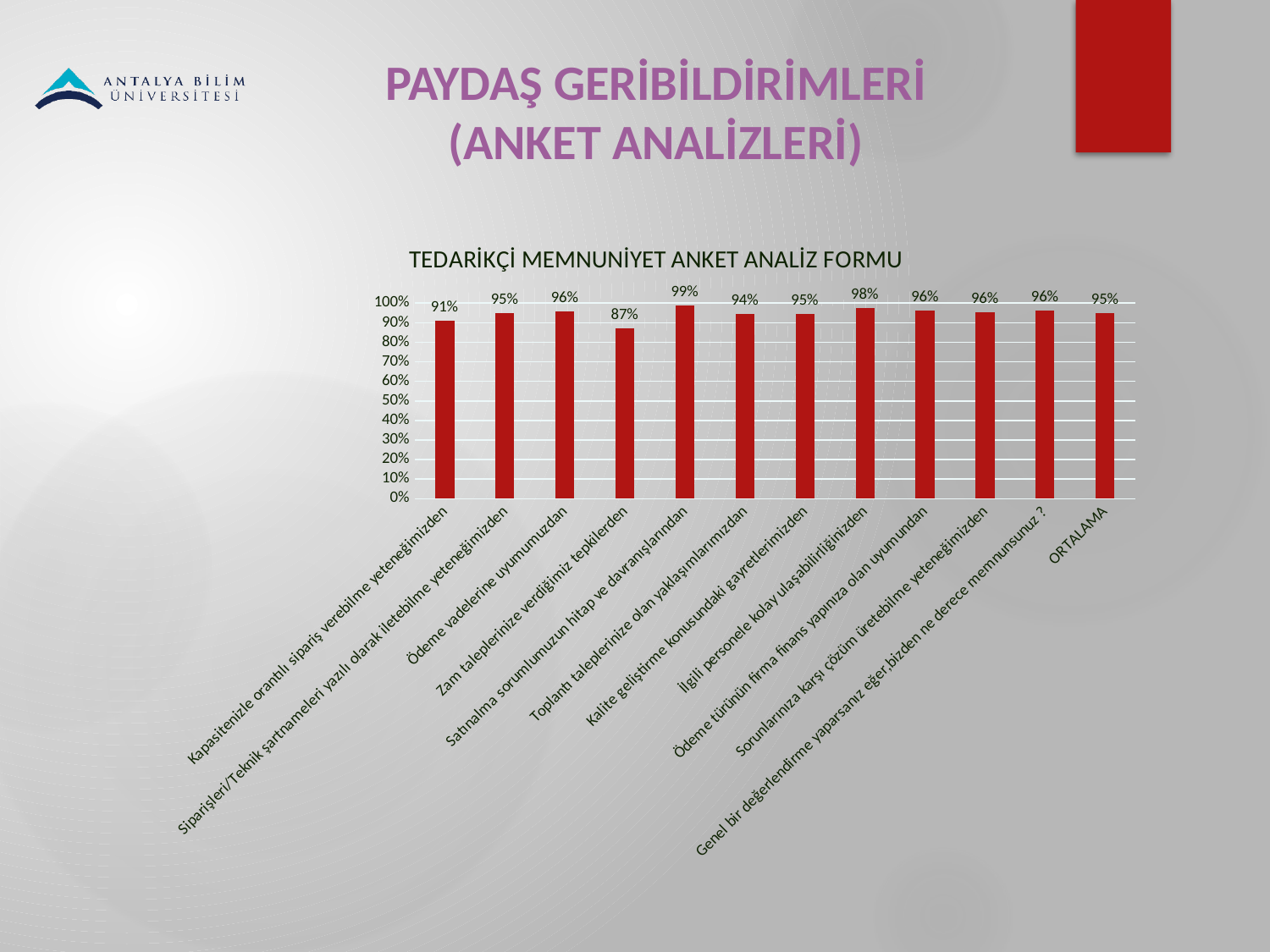
Which is larger: the value for 'İlgili personele kolay ulaşabilirliğinizden' or the value for 'Toplantı taleplerinize olan yaklaşımlarımızdan'? İlgili personele kolay ulaşabilirliğinizden What is the value for 'Kapasitenizle orantılı sipariş verebilme yeteneğimizden'? 91% What is the title of the chart? TEDARİKÇİ MEMNUNİYET ANKET ANALİZ FORMU Which category has the lowest value? Zam taleplerinize verdiğimiz tepkilerden Which category has the highest value? Satınalma sorumlumuzun hitap ve davranışlarından What is the value for 'Zam taleplerinize verdiğimiz tepkilerden'? 87% How many bars are plotted in the chart? 12 What is the value for ORTALAMA? 95% What is the value for 'Ödeme vadelerine uyumumuzdan'? 96% What is the difference between the highest value (99%) and the lowest value (87%)? 12% What is the value for 'Satınalma sorumlumuzun hitap ve davranışlarından'? 99% What type of chart is shown on the slide? Bar chart